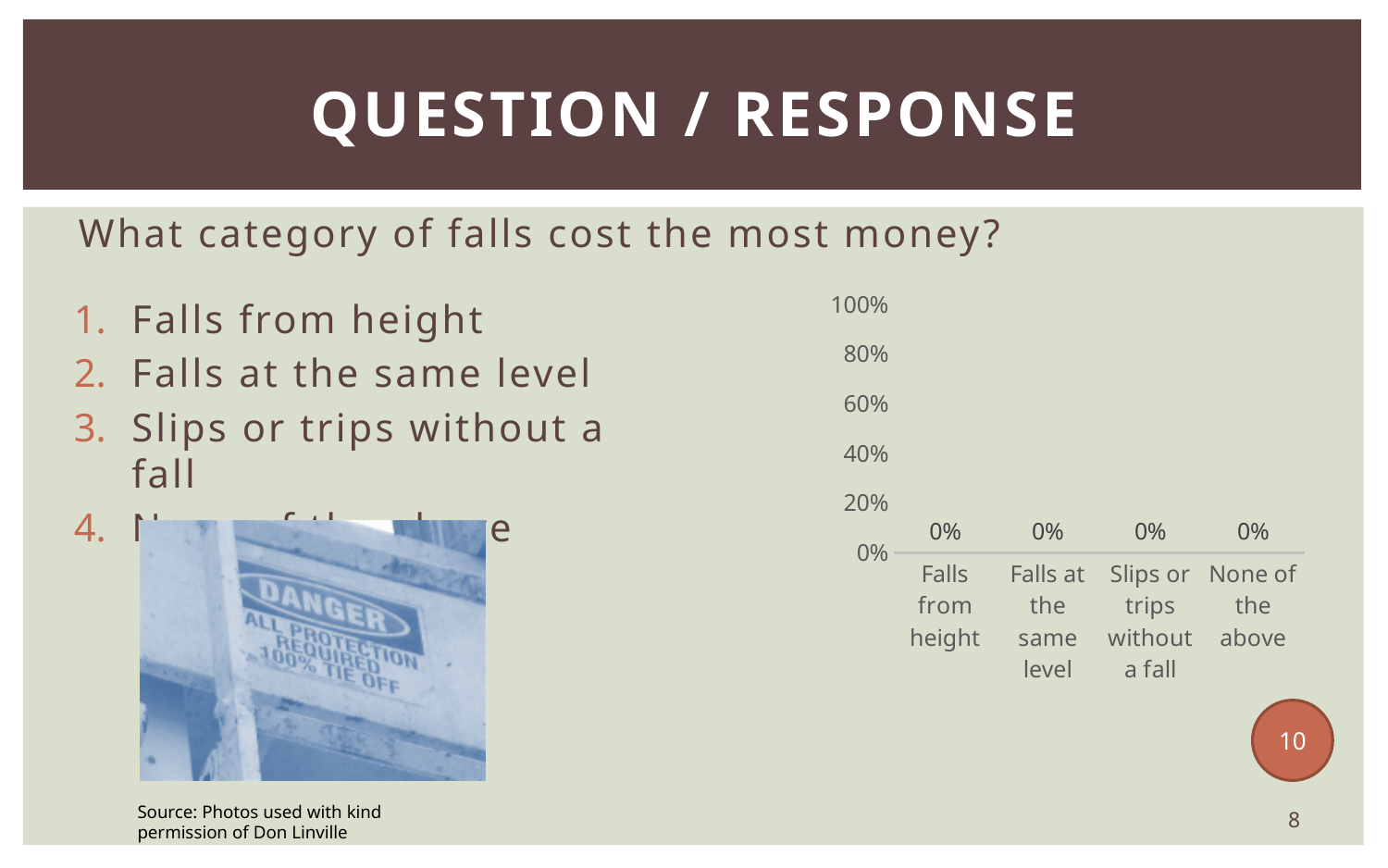
What is the highest value shown on the y axis of the chart? 100% What is the value for Slips or trips without a fall? 0% What kind of chart is shown on the slide? bar chart How many categories are shown on the x axis of the chart? 4 What is the value for Falls at the same level? 0% What is the value for Falls from height? 0% What is the label of the first category on the x axis? Falls from height What is the value for None of the above? 0% What is the difference between the values for Falls from height and None of the above? 0% Is the value for Slips or trips without a fall greater or less than 20%? less